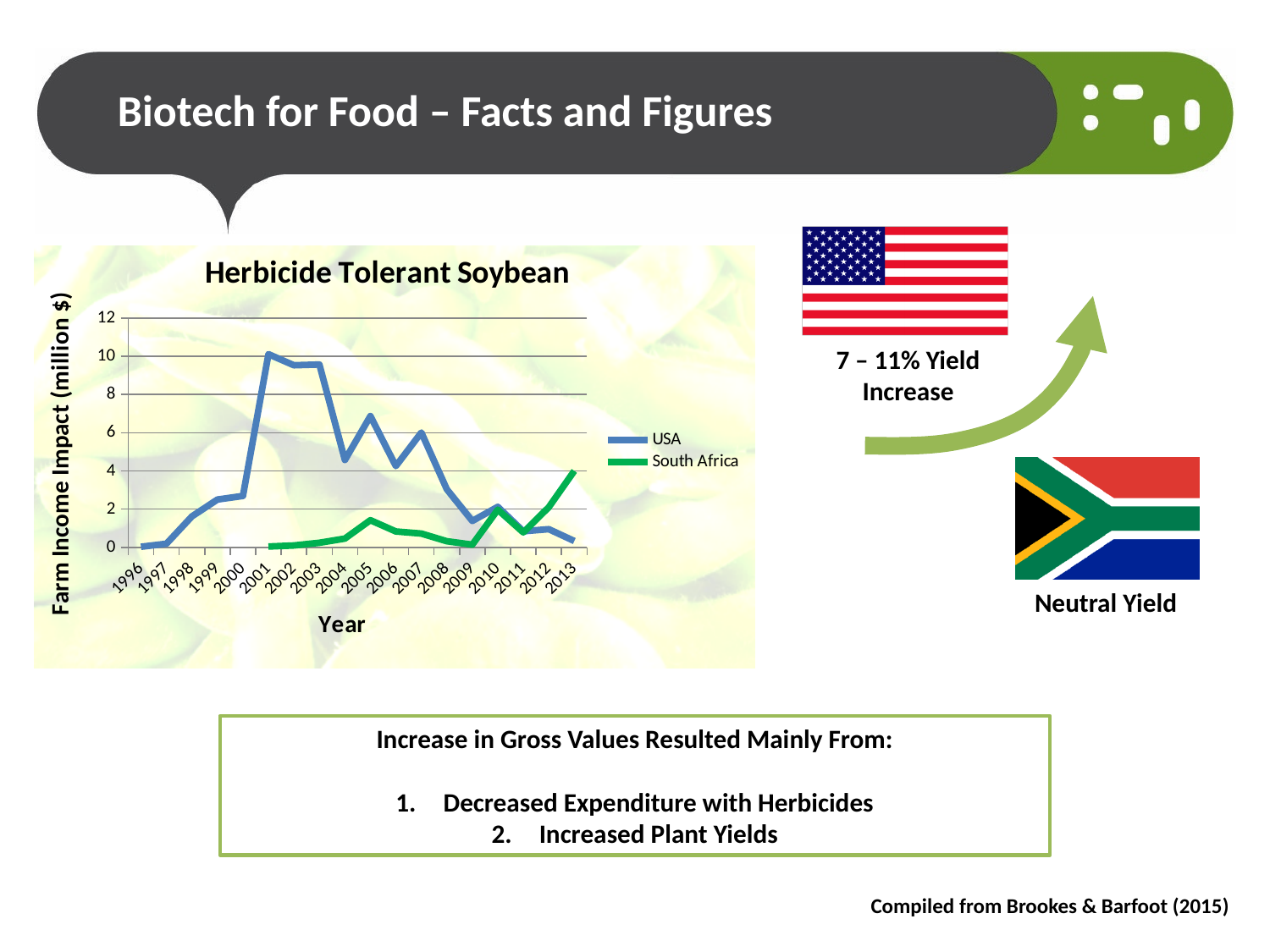
In which year does the USA series reach its highest value? 2001 Is the South Africa value for 2013 greater or less than 2? greater Is the USA value for 2001 greater or less than 8? greater How many series does the legend list? 2 Which two series are shown in the legend? USA and South Africa What is the title of the chart? Herbicide Tolerant Soybean Does the South Africa series rise or fall from 2011 to 2013? rise In 2013, which series has the larger value, USA or South Africa? South Africa Is the USA value for 1996 greater or less than 2? less What kind of chart is shown on the slide? line chart How many years are shown on the x axis? 18